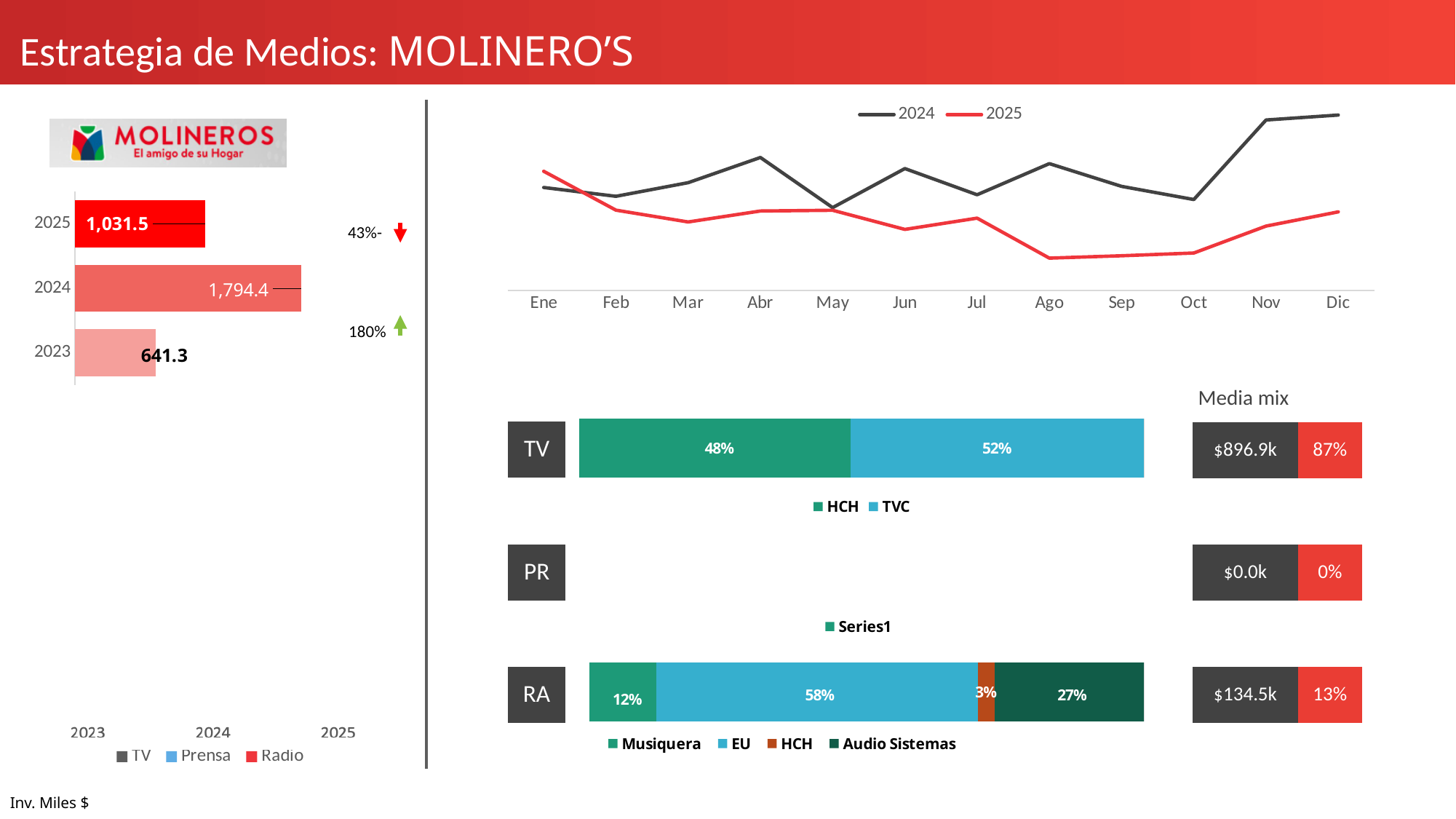
In the bar chart on the left, what is the value for 2023? 641.3 In the bar chart on the left, which year has the highest value? 2024 In the RA stacked bar, what percentage is EU? 58% In the line chart, which series has the higher value in Ene, 2024 or 2025? 2025 In the bar chart on the left, what is the difference between the 2024 and 2025 values? 762.9 In the Media mix column, what is the amount shown for TV? $896.9k How many series does the legend of the monthly line chart list? 2 How many months are shown on the x axis of the line chart? 12 What kind of chart is the monthly chart at the top right? Line chart In the bar chart on the left, what is the value for 2024? 1,794.4 In the TV stacked bar, what percentage is TVC? 52% In the RA stacked bar, which segment is the largest? EU